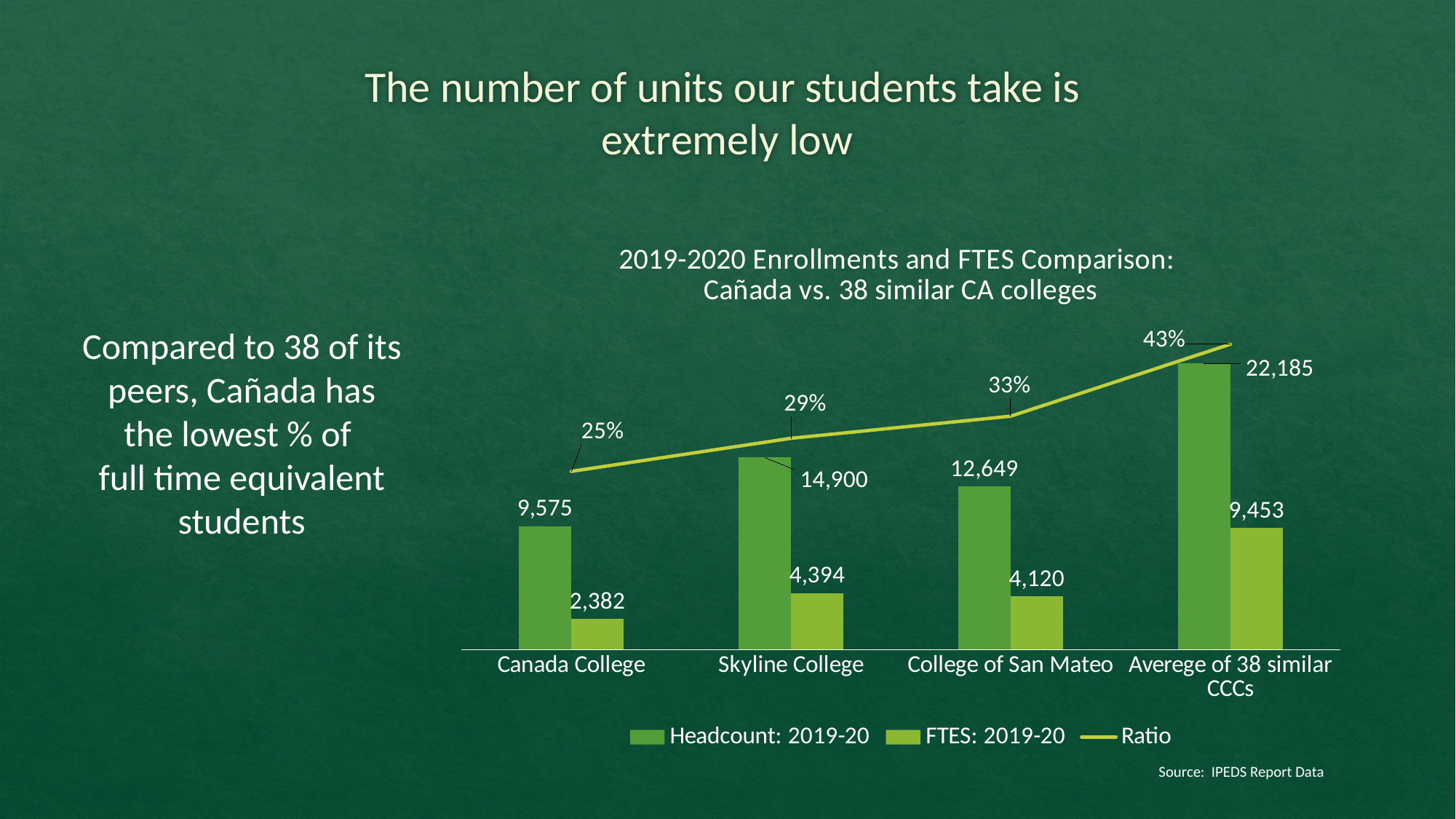
Does the Ratio line rise or fall from Canada College to Averege of 38 similar CCCs? rise What is the difference between the Headcount: 2019-20 values for Skyline College and College of San Mateo? 2,251 How many categories are shown on the x axis? 4 What is the Headcount: 2019-20 value for Canada College? 9,575 Which category has the lowest FTES: 2019-20 value? Canada College What is the Ratio value for College of San Mateo? 33% What is the Headcount: 2019-20 value for Averege of 38 similar CCCs? 22,185 How many series does the legend list? 3 What is the title of the chart? 2019-2020 Enrollments and FTES Comparison: Cañada vs. 38 similar CA colleges Which is larger, the FTES: 2019-20 value for College of San Mateo or for Skyline College? Skyline College Which category has the highest Ratio value? Averege of 38 similar CCCs What is the FTES: 2019-20 value for Skyline College? 4,394